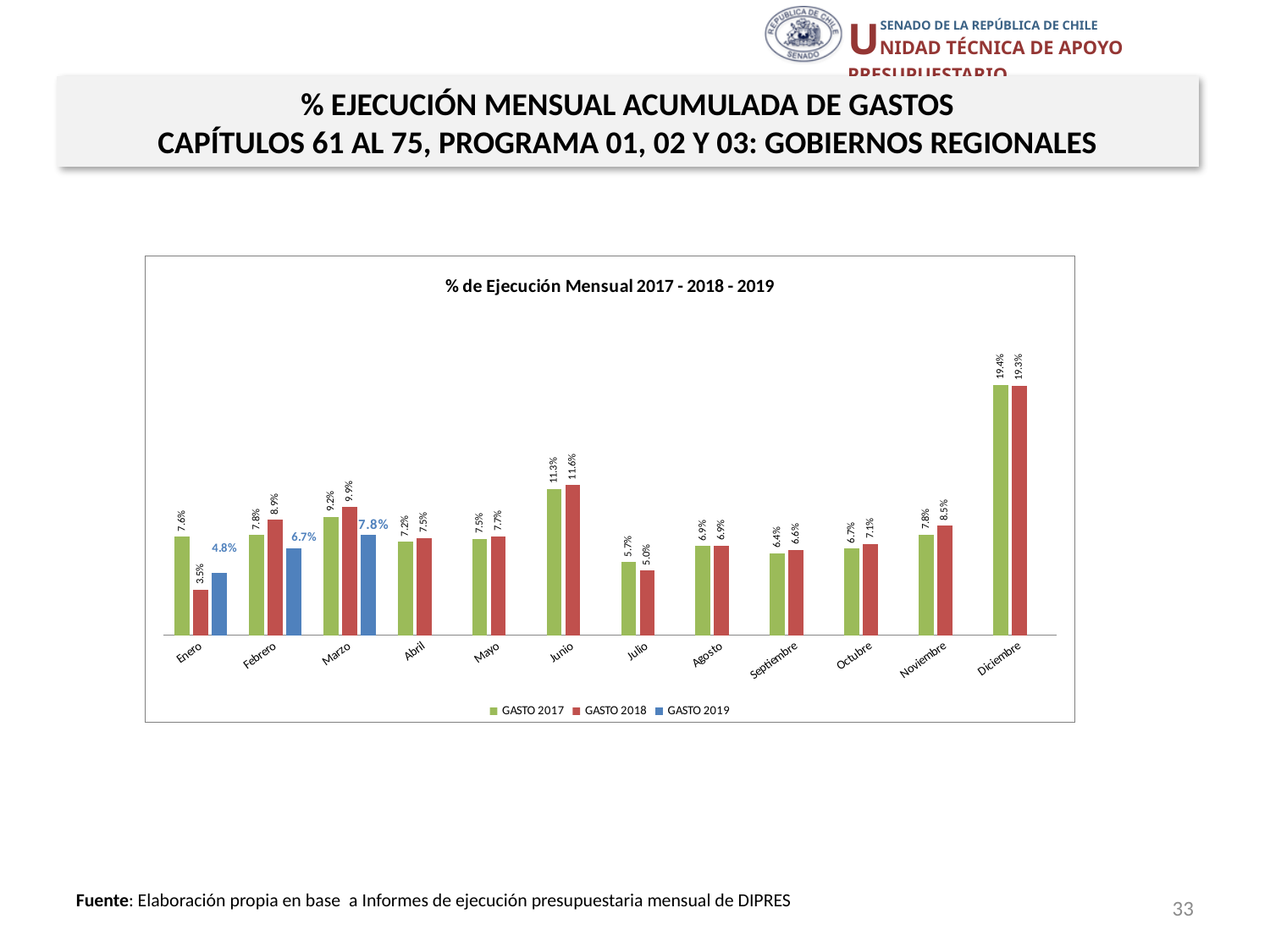
How many series does the legend list? 3 What is the GASTO 2019 value for Marzo? 7.8% What is the GASTO 2017 value for Junio? 11.3% What is the difference between the GASTO 2017 and GASTO 2018 values for Febrero? 1.1% Which month has the highest GASTO 2018 value? Diciembre Which is larger for Julio: GASTO 2017 or GASTO 2018? GASTO 2017 What is the title of the chart? % de Ejecución Mensual 2017 - 2018 - 2019 What kind of chart is shown on the slide? Bar chart What is the difference between the GASTO 2019 values for Marzo and Enero? 3.0% Which month has the lowest GASTO 2017 value? Julio What is the GASTO 2018 value for Enero? 3.5% How many months are shown on the x axis? 12